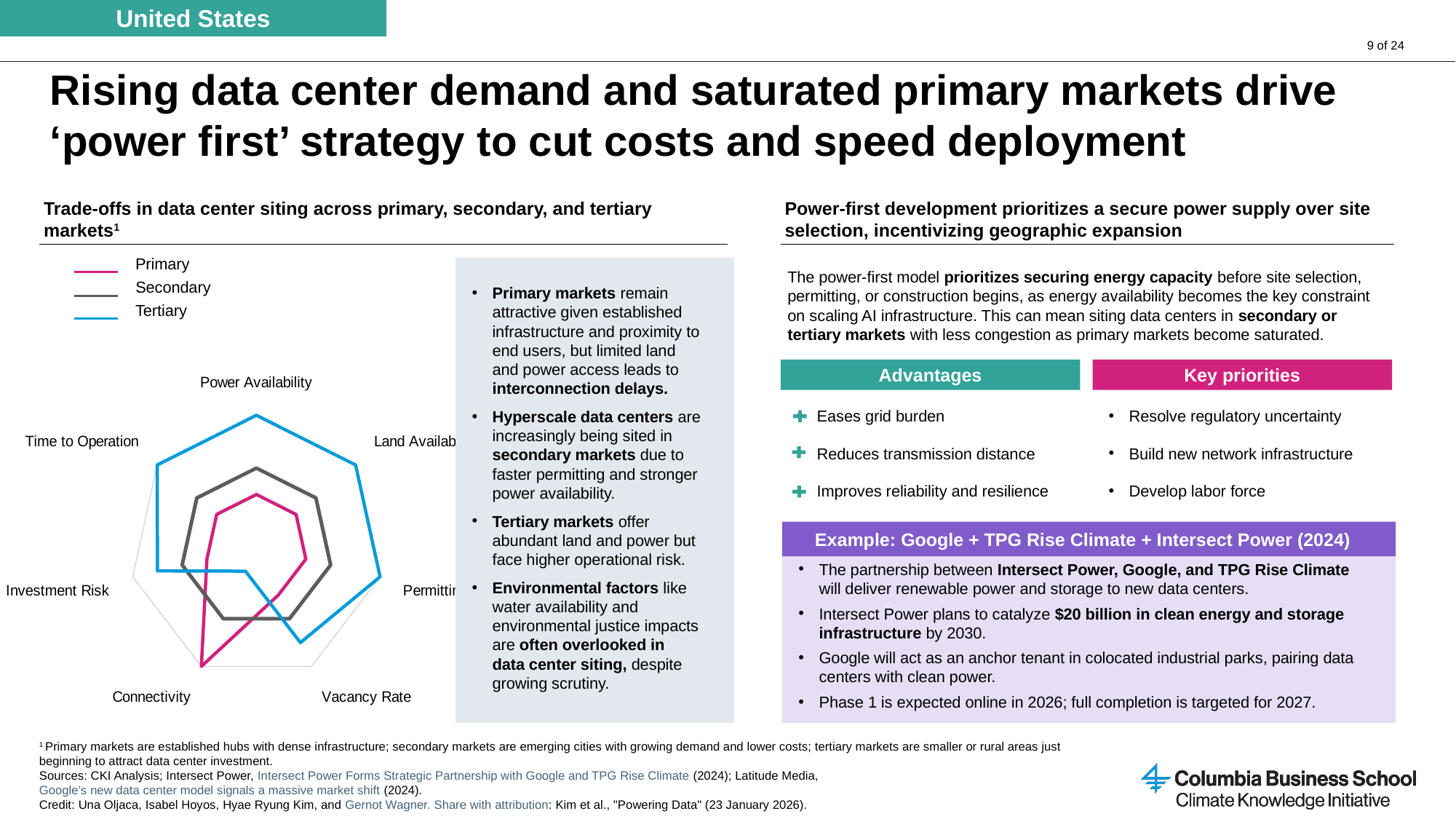
How many series does the legend of the radar chart list? 3 Which series has the lowest value on the Vacancy Rate axis of the radar chart? Primary Which series has the lowest value on the Power Availability axis of the radar chart? Primary On the Vacancy Rate axis of the radar chart, which series is larger: Primary or Tertiary? Tertiary Which series has the highest value on the Power Availability axis of the radar chart? Tertiary On the Time to Operation axis of the radar chart, which series is larger: Secondary or Tertiary? Tertiary On the Investment Risk axis of the radar chart, which series is larger: Primary or Secondary? Secondary How many axes (categories) does the radar chart have? 7 Which series has the highest value on the Connectivity axis of the radar chart? Primary What kind of chart is shown on the left side of the slide? Radar chart Which series in the radar chart is drawn in gray? Secondary What colour is the Tertiary series in the radar chart? Blue